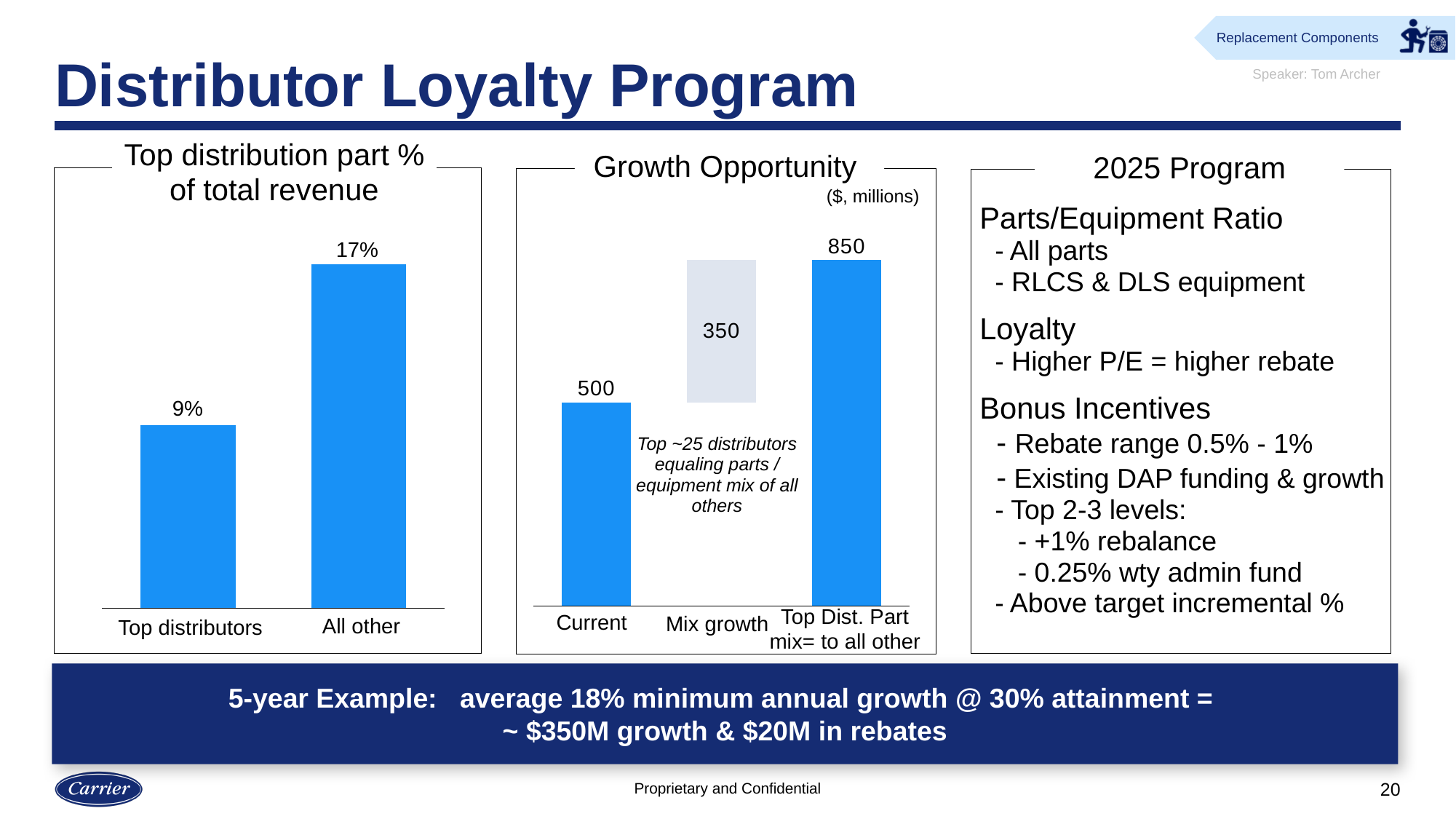
In the 'Growth Opportunity' chart, what is the value for 'Top Dist. Part mix= to all other'? 850 In the 'Growth Opportunity' chart, which category has the lowest value? Mix growth In the 'Growth Opportunity' chart, what is the difference between 'Top Dist. Part mix= to all other' and Current? 350 In the 'Growth Opportunity' chart, what unit is stated for the values? $, millions In the 'Top distribution part % of total revenue' chart, what is the value for Top distributors? 9% In the 'Growth Opportunity' chart, what is the value for Mix growth? 350 In the 'Top distribution part % of total revenue' chart, what is the value for All other? 17% In the 'Top distribution part % of total revenue' chart, how many categories are shown? 2 In the 'Growth Opportunity' chart, what is the value for Current? 500 What kind of chart is the 'Top distribution part % of total revenue' chart? Bar chart In the 'Top distribution part % of total revenue' chart, what is the difference between All other and Top distributors? 8% In the 'Top distribution part % of total revenue' chart, which category has the higher value? All other